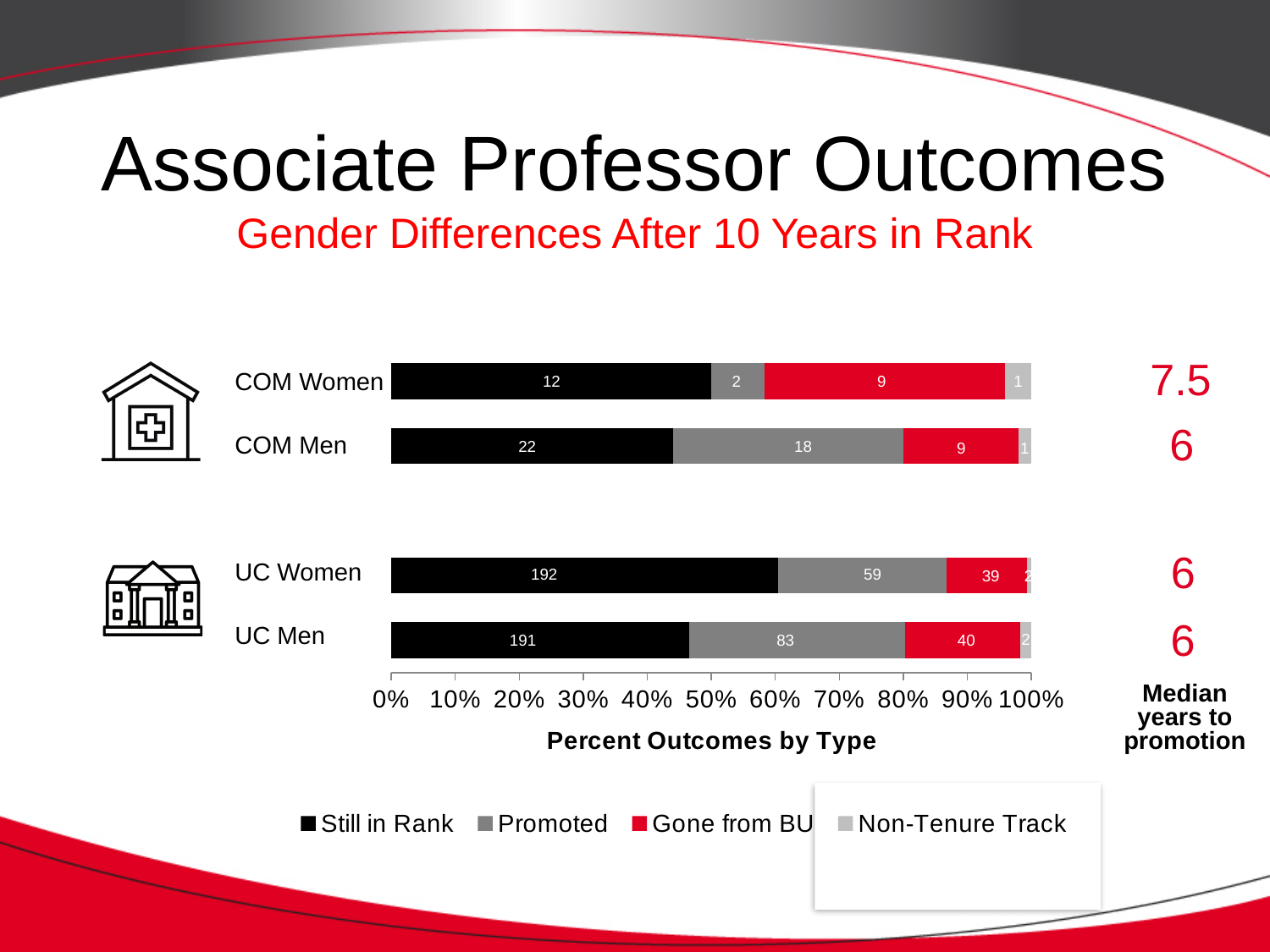
What is the Still in Rank value for UC Women? 192 What is the Gone from BU value for COM Women? 9 Is the Still in Rank share of the COM Men bar greater or less than 50%? less What is the Promoted value for UC Men? 83 What is the difference between the Promoted values for UC Men and UC Women? 24 Which category has the largest Promoted value? UC Men What is the total of the labelled values in the COM Women bar? 24 What is the Promoted value for COM Men? 18 How many categories are shown on the chart? 4 What kind of chart is shown on the slide? Stacked bar chart How many series does the legend list? 4 Which has the larger Gone from BU value, UC Men or UC Women? UC Men